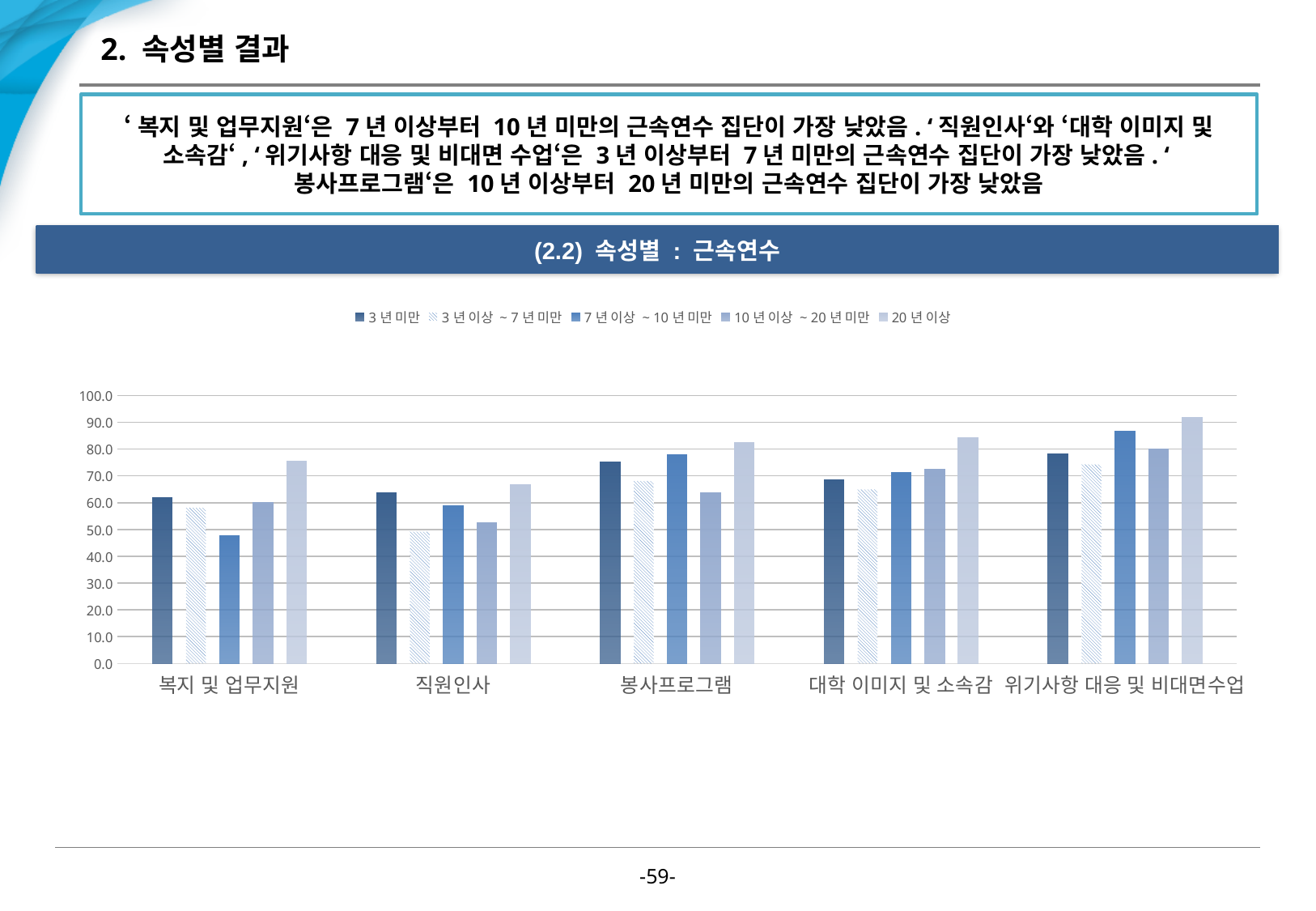
What kind of chart is shown on the slide? bar chart How many categories are shown on the x axis? 5 For the category 봉사프로그램, which series has the lowest bar? 10 년 이상 ~ 20 년 미만 Across all categories, which category has the lowest value for the 3 년 이상 ~ 7 년 미만 series? 직원인사 In the category 직원인사, which is larger: the value for 3 년 이상 ~ 7 년 미만 or the value for 7 년 이상 ~ 10 년 미만? 7 년 이상 ~ 10 년 미만 How many series does the legend list? 5 Is the value for 7 년 이상 ~ 10 년 미만 in the category 복지 및 업무지원 greater or less than 60? less For the category 위기사항 대응 및 비대면수업, which series has the highest bar? 20 년 이상 Is the value for 20 년 이상 in the category 대학 이미지 및 소속감 greater or less than 80? greater For the category 복지 및 업무지원, which series has the lowest bar? 7 년 이상 ~ 10 년 미만 What is the title shown in the banner above the chart? (2.2) 속성별 : 근속연수 Across all categories, which category has the highest value for the 20 년 이상 series? 위기사항 대응 및 비대면수업